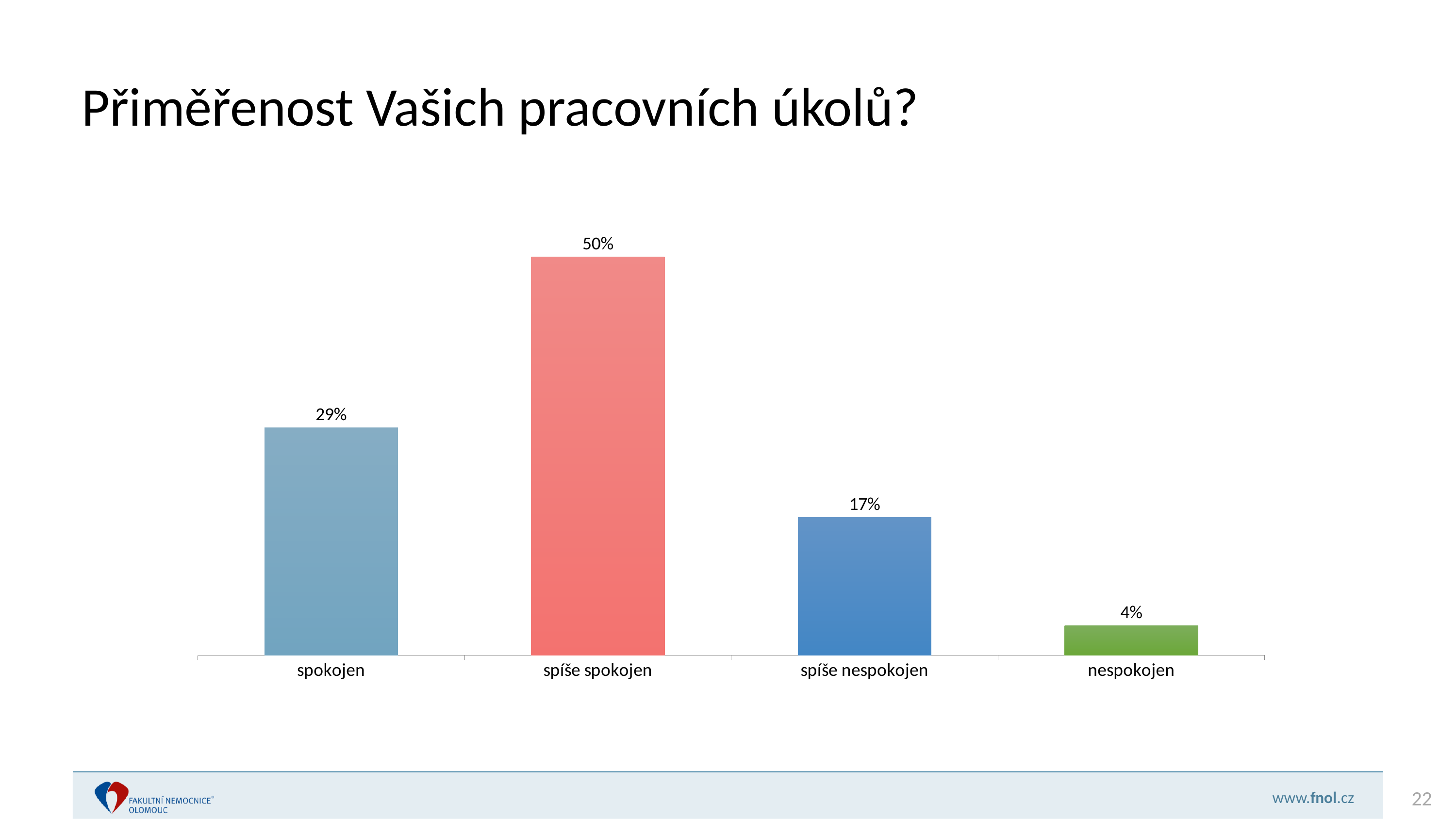
How many categories are shown on the x axis? 4 What kind of chart is shown on the slide? bar chart What is the value for "spíše spokojen"? 50% Which category has the highest value? spíše spokojen What is the difference between the values for "spíše nespokojen" and "nespokojen"? 13% What is the value for "nespokojen"? 4% Which category has the lowest value? nespokojen What is the title of the slide containing the chart? Přiměřenost Vašich pracovních úkolů? Which is larger, the value for "spokojen" or the value for "spíše nespokojen"? spokojen What is the difference between the values for "spíše spokojen" and "spokojen"? 21% What is the value for "spíše nespokojen"? 17% What is the value for "spokojen"? 29%